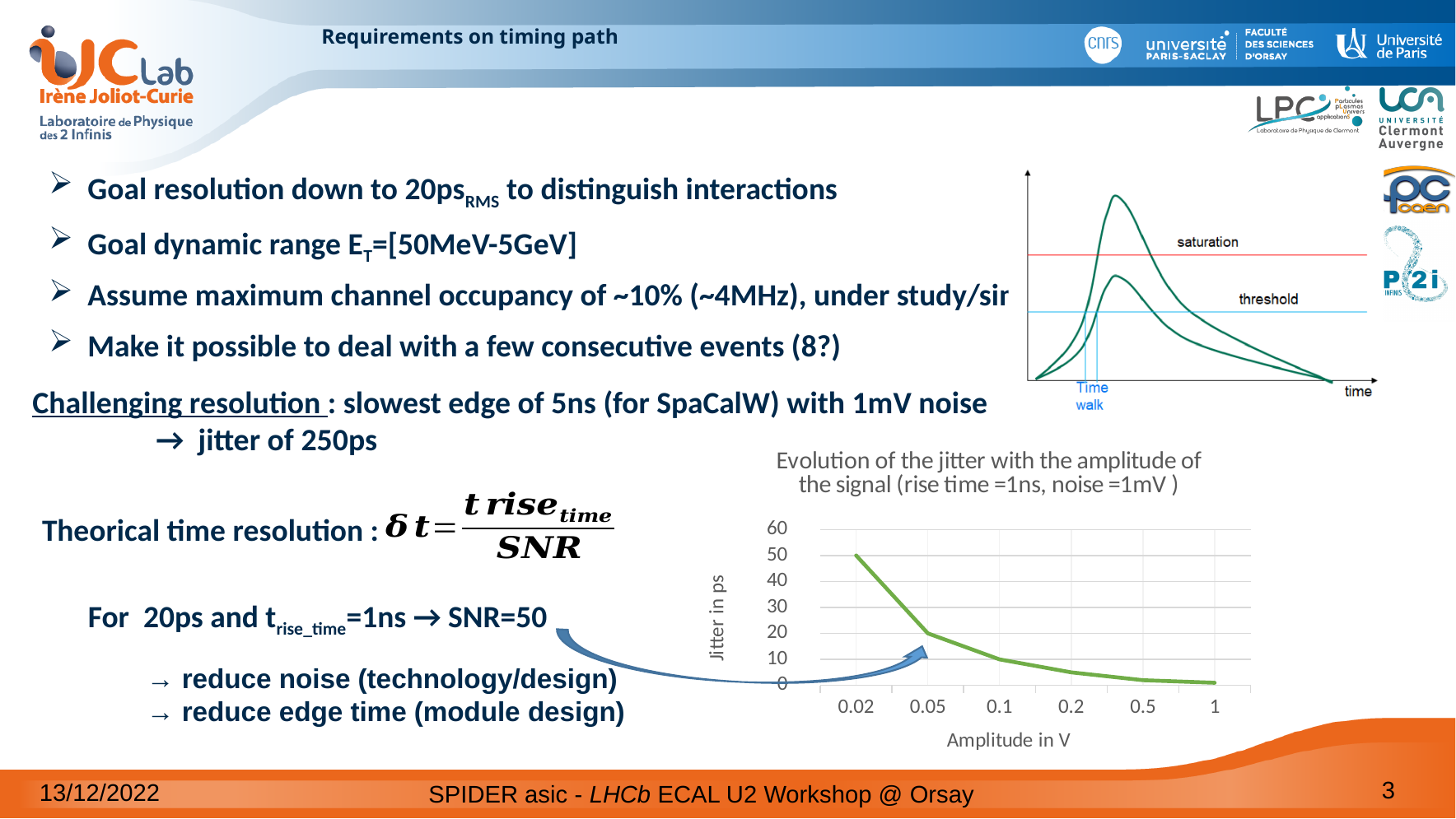
What is the label of the x axis of the jitter chart? Amplitude in V At which amplitude is the jitter lowest in the jitter chart? 1 Which amplitude has the larger jitter, 0.02 V or 0.05 V? 0.02 Does the jitter rise or fall as the amplitude increases along the x axis? fall Is the jitter at an amplitude of 0.05 V greater or less than 30 ps? less Is the jitter at an amplitude of 0.1 V greater or less than 20 ps? less What is the label of the y axis of the jitter chart? Jitter in ps Is the jitter at an amplitude of 1 V greater or less than 10 ps? less At which amplitude is the jitter highest in the jitter chart? 0.02 What kind of chart is used to show the evolution of the jitter with the amplitude of the signal? line chart How many amplitude values are plotted on the x axis of the jitter chart? 6